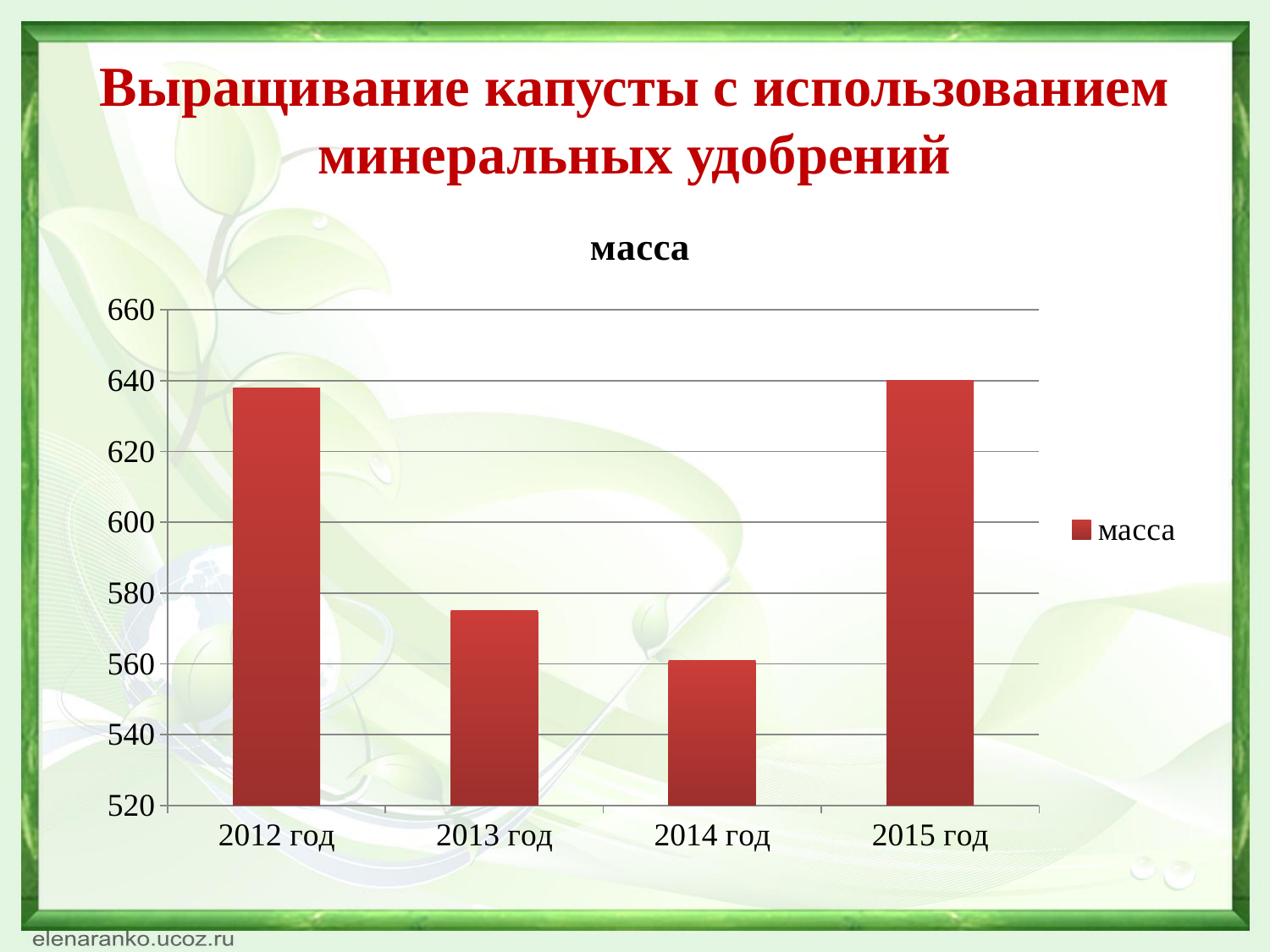
Is the value for 2012 год greater or less than 620? greater Which year has the lowest value in the chart? 2014 год How many categories (years) are shown on the x axis of the chart? 4 Is the value for 2013 год greater or less than 580? less What kind of chart is shown on the slide? bar chart What is the title of the chart? масса Is the value for 2014 год greater or less than 580? less How many series does the chart legend list? 1 Which is larger, the value for 2013 год or the value for 2014 год? 2013 год Do the values fall or rise from 2012 год to 2014 год? fall Which is larger, the value for 2012 год or the value for 2013 год? 2012 год